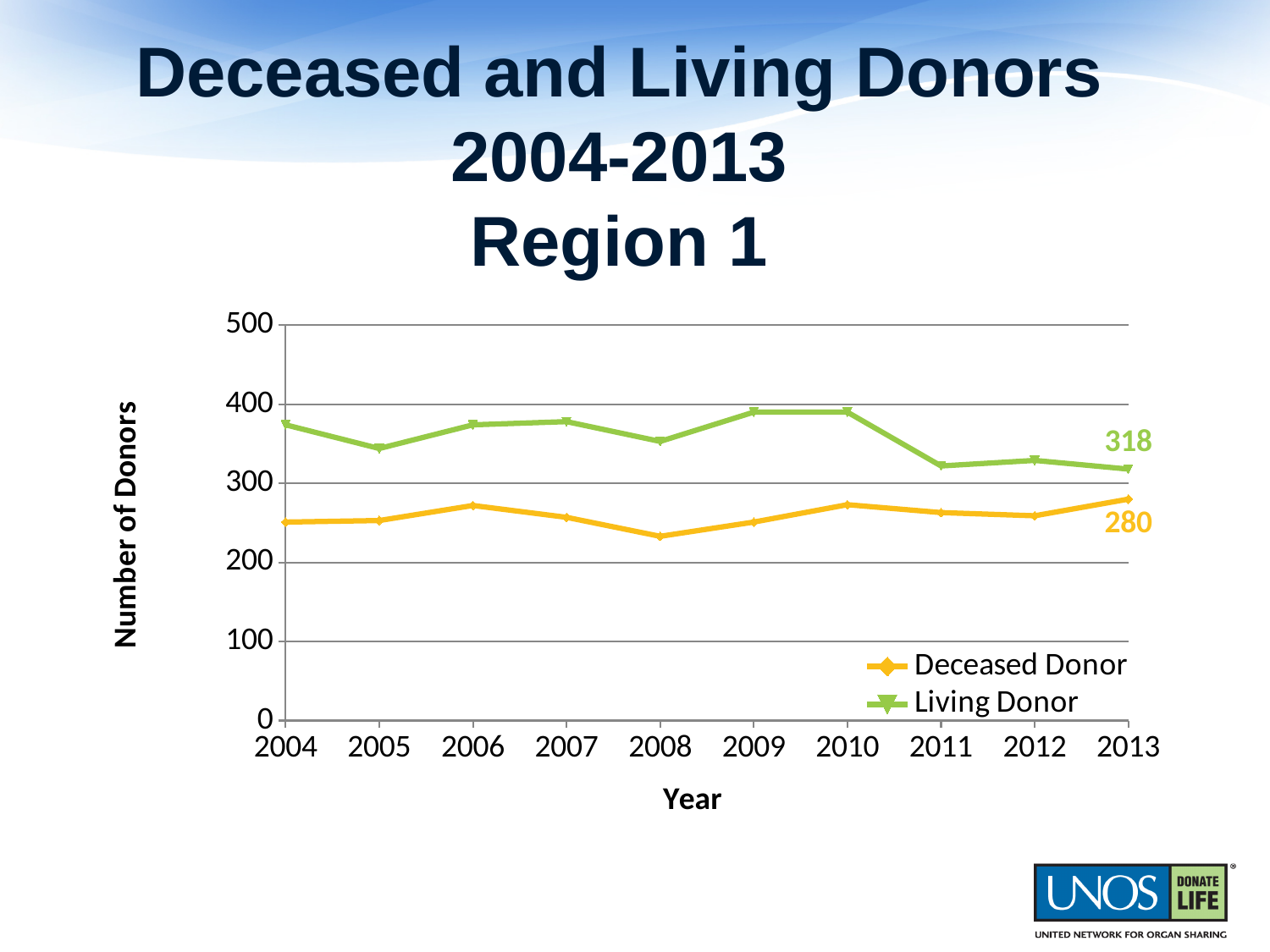
What is the difference between the Living Donor and Deceased Donor values in 2013? 38 Is the value for Deceased Donor in 2008 greater or less than 300? less How many years are shown on the x axis? 10 How many series does the legend list? 2 What kind of chart is shown on the slide? line chart Does the Living Donor value rise or fall from 2010 to 2011? fall Is the value for Living Donor in 2004 greater or less than 300? greater What is the value for Deceased Donor in 2013? 280 In 2013, which series has the larger value, Living Donor or Deceased Donor? Living Donor In which year is the Deceased Donor value lowest? 2008 What is the title of the y axis? Number of Donors What is the value for Living Donor in 2013? 318